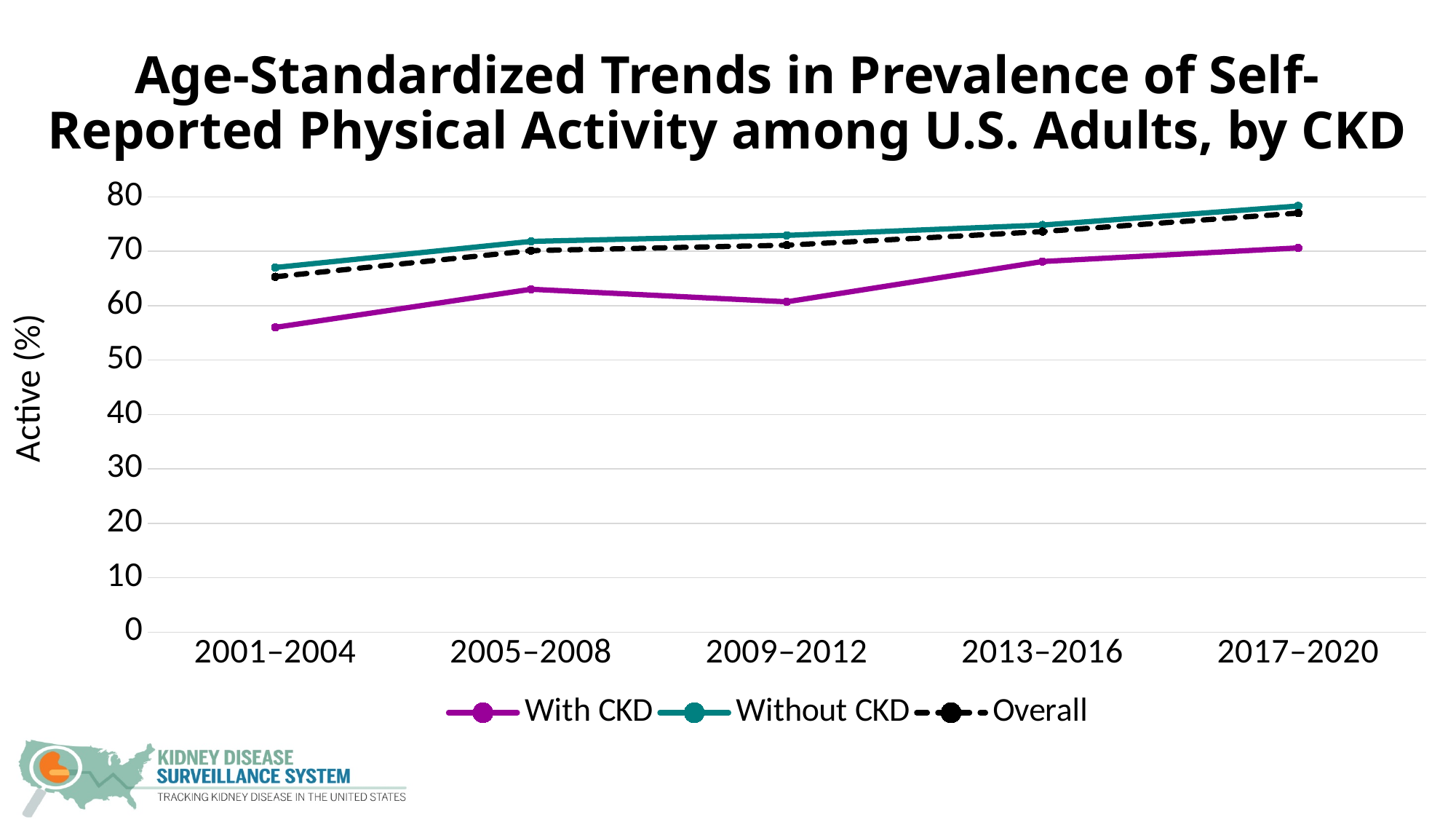
Is the value for With CKD in 2001–2004 greater or less than 60? less In 2009–2012, which is larger: With CKD or Without CKD? Without CKD In which period is the With CKD series at its highest? 2017–2020 Which series is drawn with a dashed line? Overall Is the value for Overall in 2001–2004 greater or less than 70? less In which period is the With CKD series at its lowest? 2001–2004 Is the value for With CKD in 2013–2016 greater or less than 70? less How many time periods are shown on the x axis? 5 How many series does the legend list? 3 What kind of chart is shown on the slide? line chart Does the Without CKD series rise or fall from 2001–2004 to 2017–2020? rise